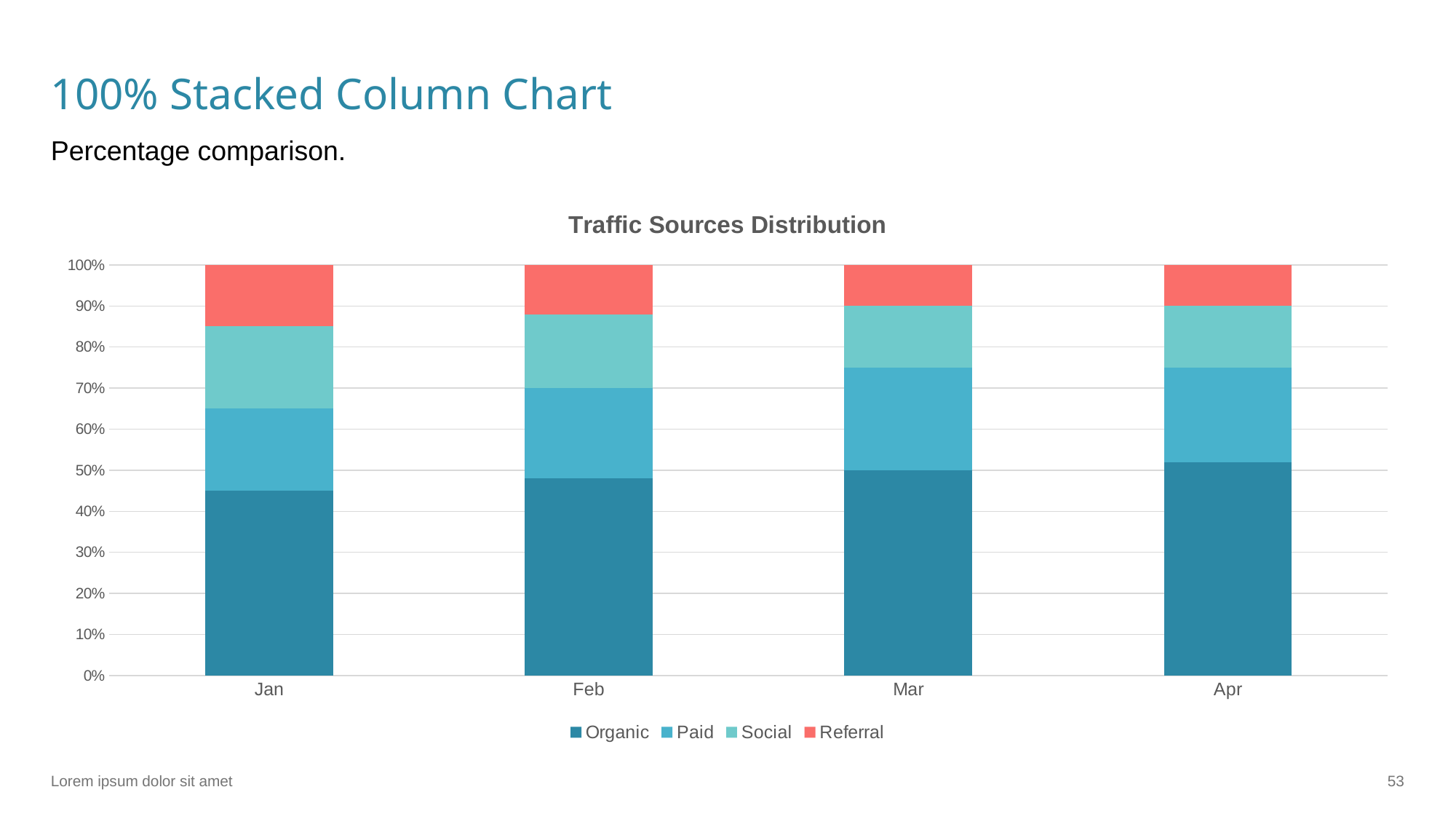
How many series does the chart legend list? 4 Which month has the largest Referral share? Jan Is the Organic share larger in Jan or in Apr? Apr What type of chart is shown on the slide? Bar chart Which month has the smallest Organic share? Jan Does the Organic share rise or fall from Jan to Apr? rise What is the title of the chart? Traffic Sources Distribution Which series are listed in the chart legend? Organic, Paid, Social, Referral Is the Organic share for Jan greater or less than 40%? greater Is the Organic share for Apr greater or less than 40%? greater Is the Organic share for Jan greater or less than 50%? less How many months are shown on the x axis of the chart? 4